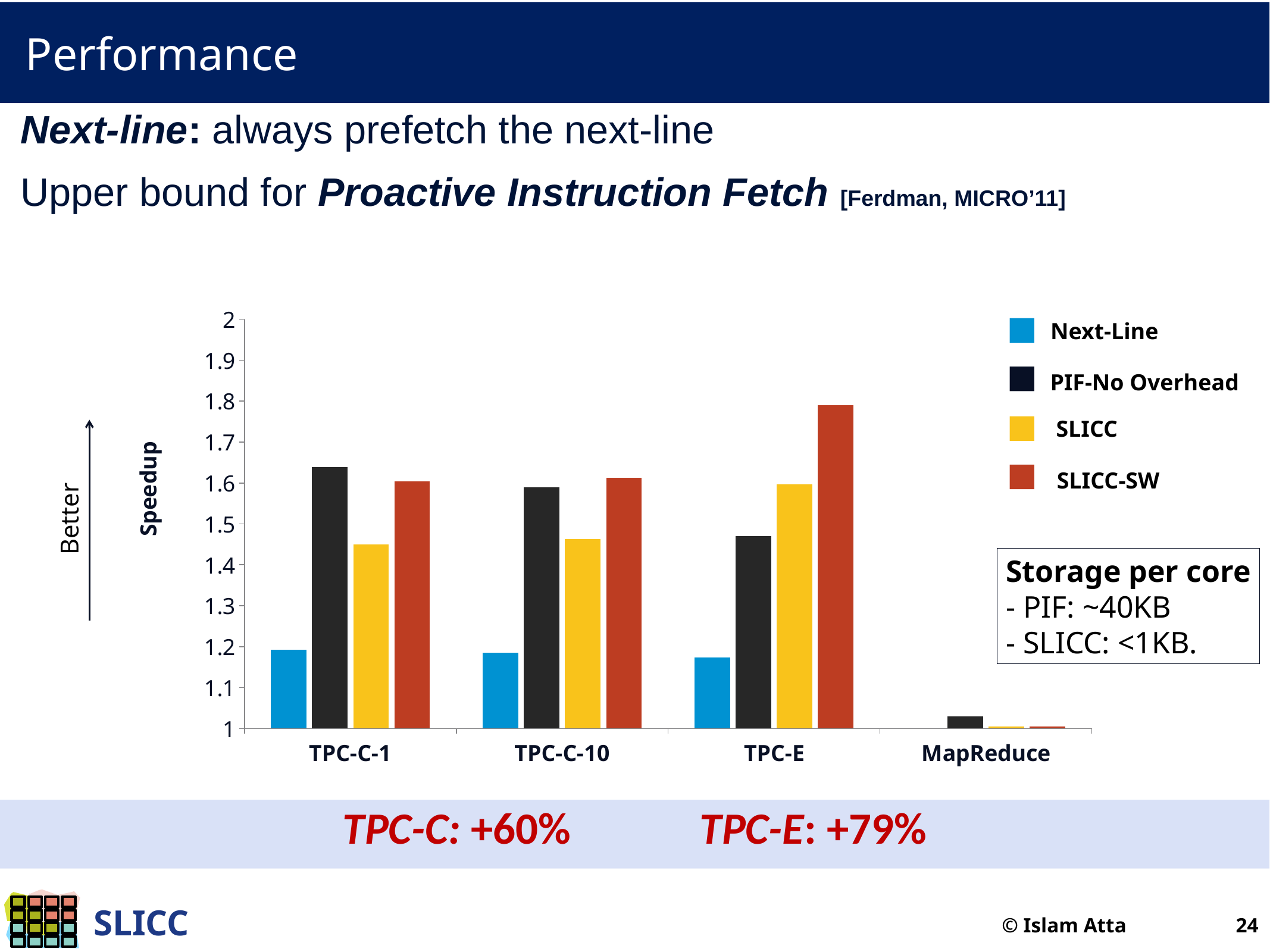
Is the SLICC value for TPC-C-10 greater or less than 1.4? greater Is the SLICC-SW value for TPC-E greater or less than 1.7? greater Which category has the highest SLICC-SW speedup? TPC-E What is the label of the chart's y axis? Speedup How many categories are shown on the x axis of the chart? 4 Which series is shown in yellow in the chart's legend? SLICC For TPC-E, which is larger: the SLICC value or the PIF-No Overhead value? SLICC What kind of chart is shown on the slide? bar chart For TPC-C-1, which is larger: the PIF-No Overhead value or the SLICC value? PIF-No Overhead Is the Next-Line value for TPC-C-1 greater or less than 1.3? less Which category has the lowest PIF-No Overhead speedup? MapReduce How many series does the chart's legend list? 4